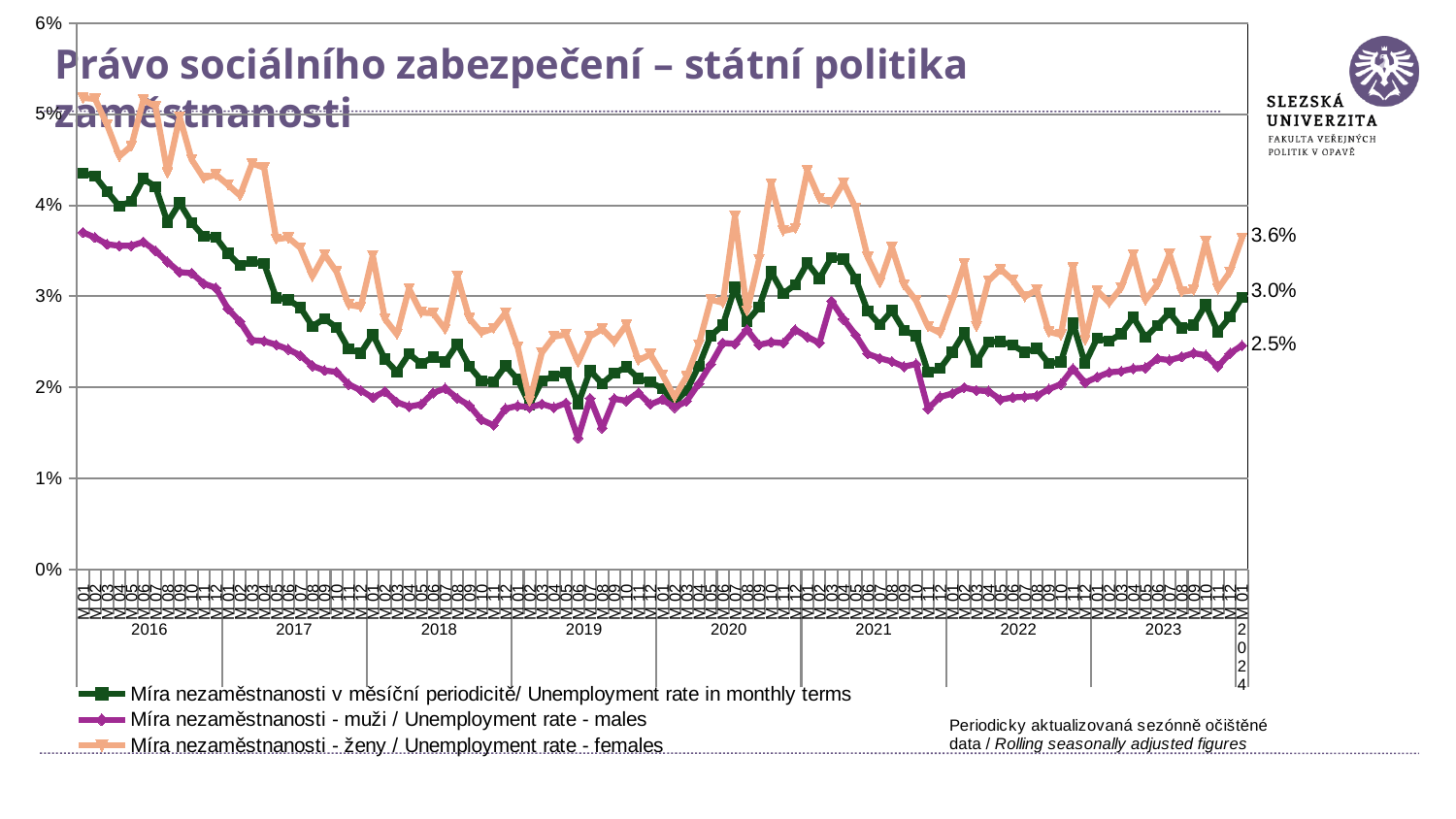
What is the difference between the last labelled values for females (3.6%) and males (2.5%)? 1.1% How many year labels are shown on the x axis? 9 What is the last labelled value for the females series (Unemployment rate - females)? 3.6% Which series has the lowest values across the whole chart? Unemployment rate - males At the end of the series, which is larger: the unemployment rate for females or for males? females Does the overall unemployment rate rise or fall from 2016 to 2019? fall What is the last labelled value for the overall series (Unemployment rate in monthly terms)? 3.0% How many series does the legend list? 3 What kind of chart is shown on the slide? line chart Is the value for females at the start of 2016 greater or less than 4%? greater Which series has the highest values across the whole chart? Unemployment rate - females What is the last labelled value for the males series (Unemployment rate - males)? 2.5%